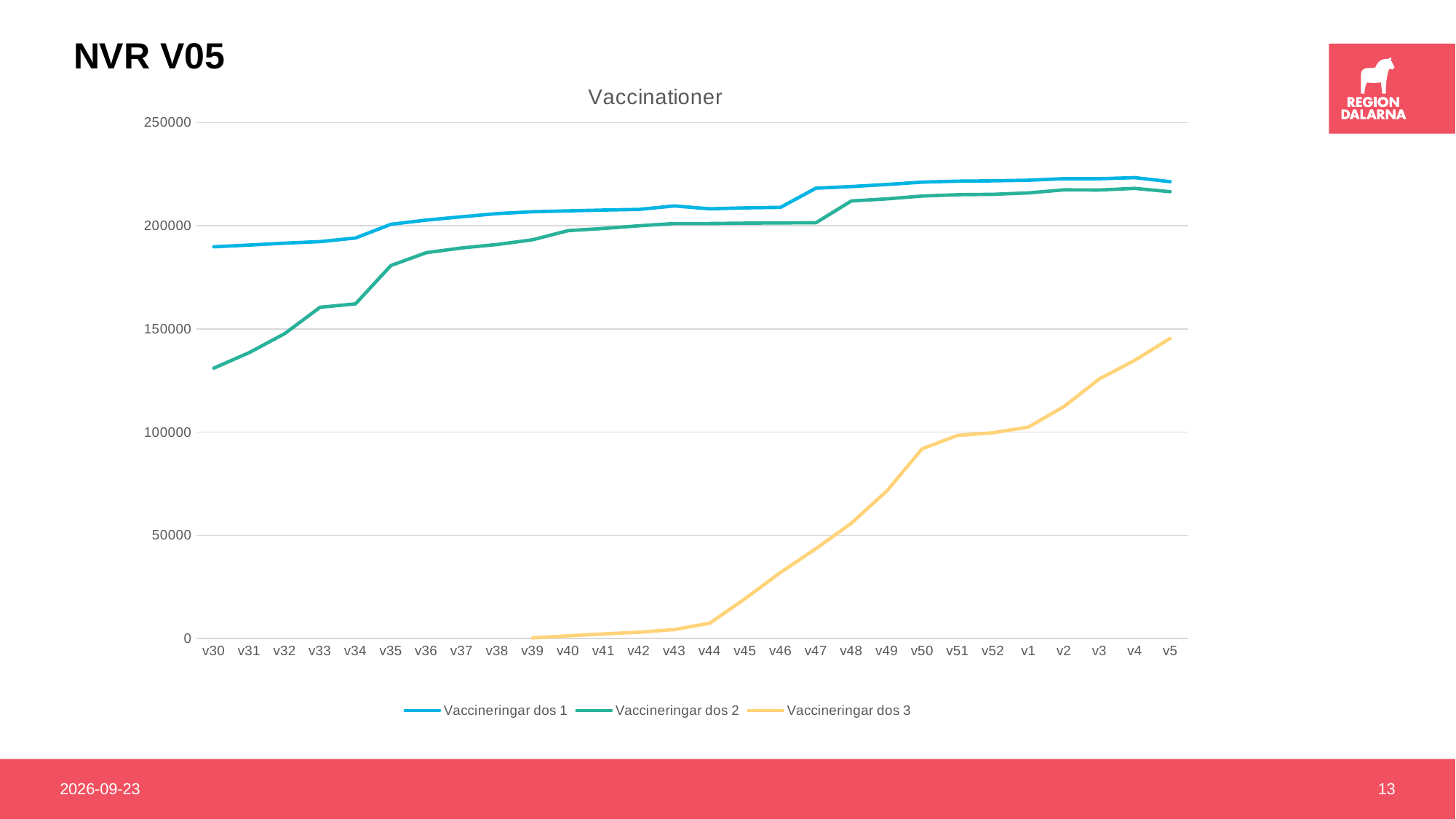
Is the value for Vaccineringar dos 3 at v44 greater or less than 50000? less At v5, which series has the higher value, Vaccineringar dos 1 or Vaccineringar dos 3? Vaccineringar dos 1 Is the value for Vaccineringar dos 2 at v30 greater or less than 150000? less How many series does the legend list? 3 Which series has the highest value at v5? Vaccineringar dos 1 What kind of chart is shown on the slide? line chart What is the title of the chart? Vaccinationer Is the value for Vaccineringar dos 1 at v30 greater or less than 200000? less How many week categories are shown on the x axis? 28 Does the Vaccineringar dos 3 line rise or fall from v39 to v5? rise